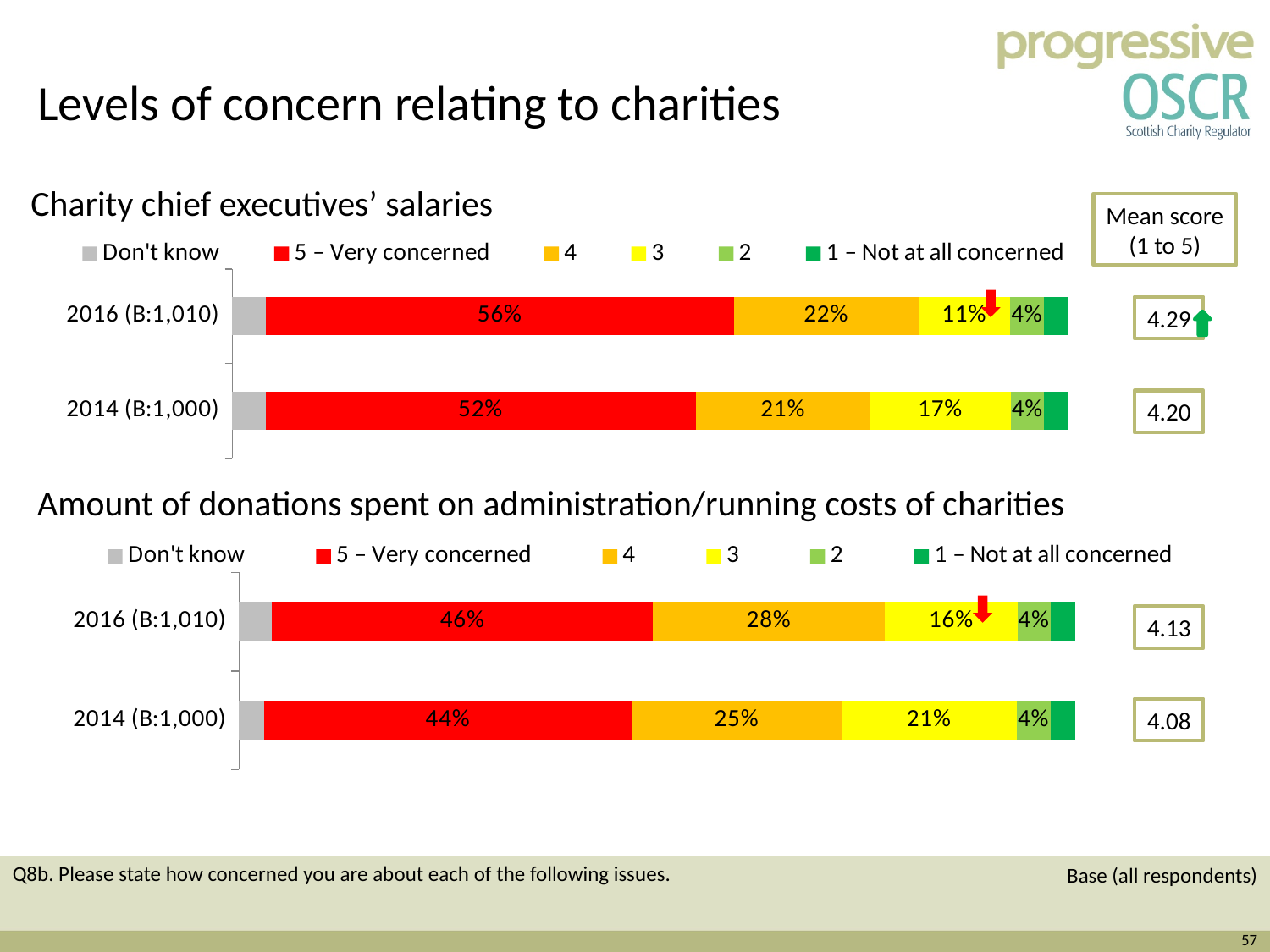
In the 'Amount of donations spent on administration/running costs of charities' chart, what percentage of 2014 respondents were '5 – Very concerned'? 44% How many series does the legend list in the 'Charity chief executives' salaries' chart? 6 In the 'Charity chief executives' salaries' chart, what is the mean score shown for 2016? 4.29 In the 'Amount of donations spent on administration/running costs of charities' chart, what percentage of 2016 respondents gave a rating of 4? 28% How many years (bars) are shown in the 'Amount of donations spent on administration/running costs of charities' chart? 2 In the 'Charity chief executives' salaries' chart, which year had the higher '5 – Very concerned' share? 2016 In the 'Charity chief executives' salaries' chart, by how many percentage points did the '5 – Very concerned' share change from 2014 to 2016? 4 percentage points What type of chart is used for 'Amount of donations spent on administration/running costs of charities'? Stacked bar chart In the 'Charity chief executives' salaries' chart, what percentage of 2016 respondents were '5 – Very concerned'? 56% In the 'Charity chief executives' salaries' chart, what percentage of 2014 respondents gave a rating of 3? 17% In the 'Amount of donations spent on administration/running costs of charities' chart, which year had the larger share rating 3, 2014 or 2016? 2014 In the 'Amount of donations spent on administration/running costs of charities' chart, what is the mean score shown for 2014? 4.08